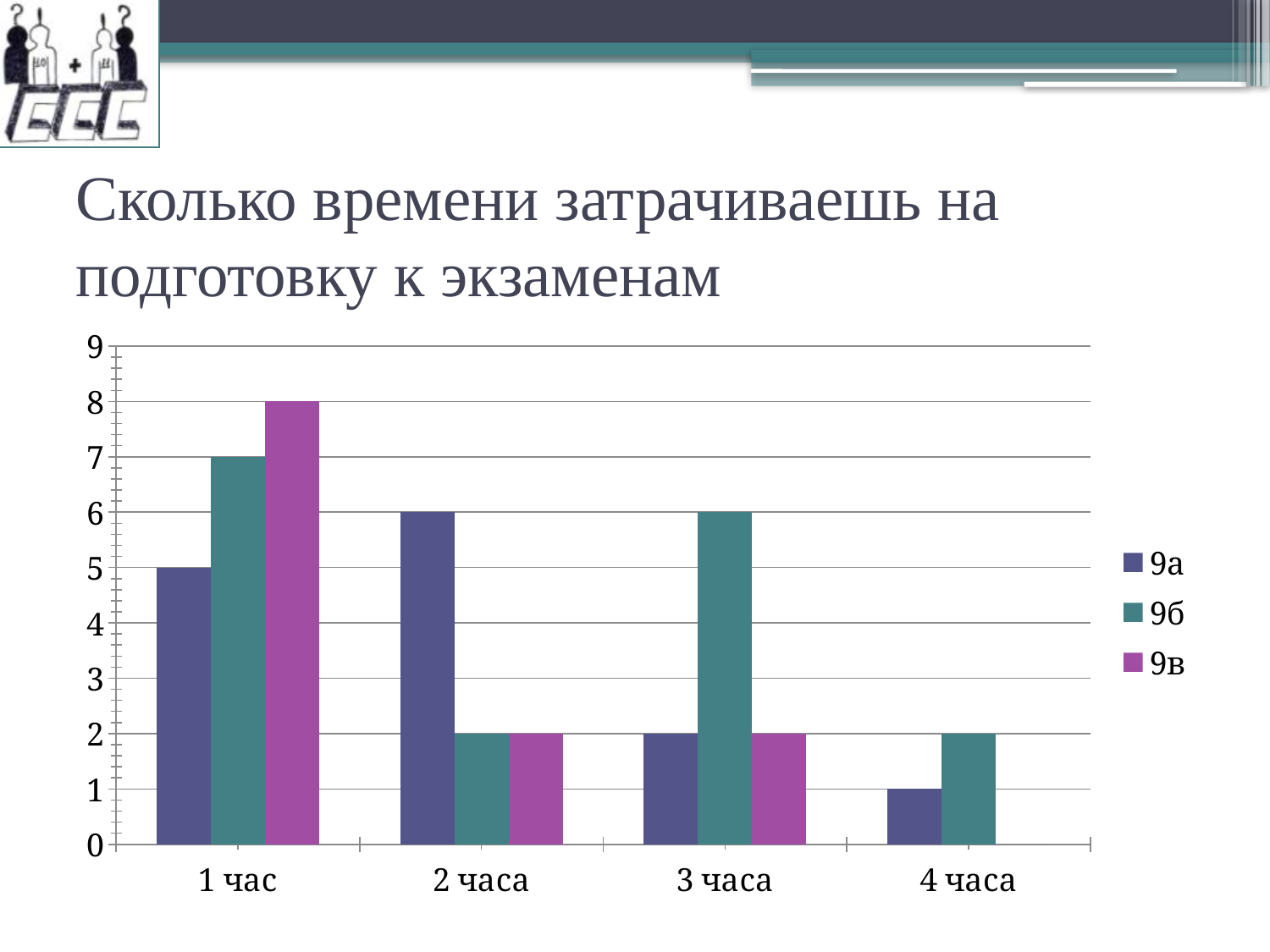
What kind of chart is shown on the slide? bar chart What is the value for 9в at 1 час? 8 What is the difference between the 9в and 9а values at 1 час? 3 What is the value for 9а at 2 часа? 6 Does the value for 9а fall or rise from 2 часа to 4 часа? fall Which is larger at 2 часа: the value for 9а or the value for 9б? 9а What is the value for 9б at 3 часа? 6 How many categories are shown on the x axis? 4 Which category has the highest value for the 9б series? 1 час Which category has the lowest value for the 9а series? 4 часа What is the value for 9а at 4 часа? 1 How many series does the legend list? 3